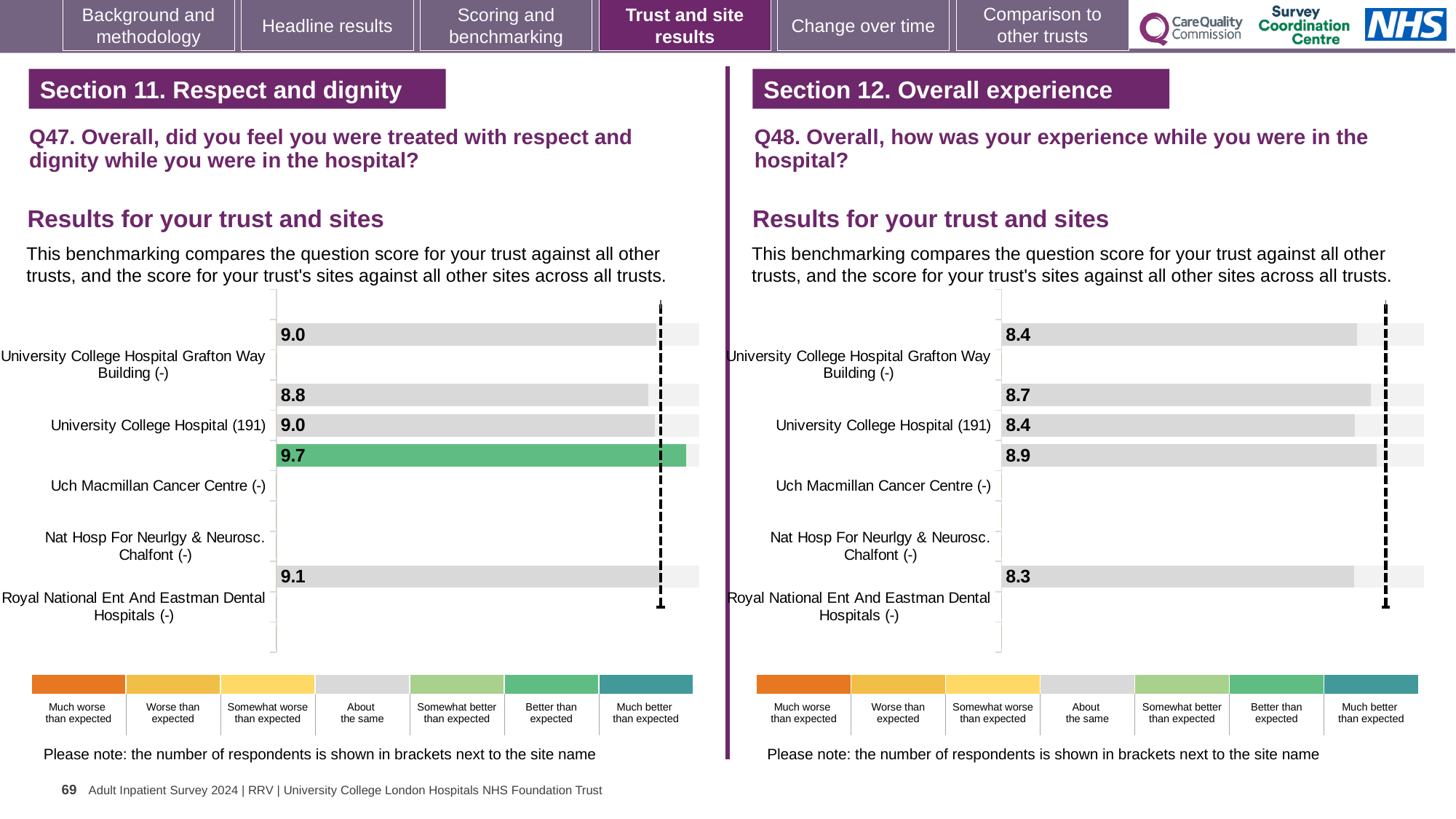
In the Q47 chart on the left, what is the difference between the highest score (9.7) and the lowest score (8.8)? 0.9 In the Q48 chart on the right, how many bars have a score printed? 5 In the Q47 chart on the left, how many bars have a score printed? 5 In the Q47 chart on the left, what is the highest score shown? 9.7 In the Q48 chart on the right, what is the difference between the highest score (8.9) and the lowest score (8.3)? 0.6 In the Q47 chart on the left, what is the value of the green bar? 9.7 In the Q48 chart on the right, what is the highest score shown? 8.9 How many rating categories are shown in the colour key below each chart? 7 In the Q47 chart on the left, what is the lowest score shown? 8.8 Which chart has the higher top score: the Q47 chart on the left or the Q48 chart on the right? Q47 chart on the left What kind of chart is used for Q47 on the left side of the slide? bar chart In the Q48 chart on the right, what is the lowest score shown? 8.3